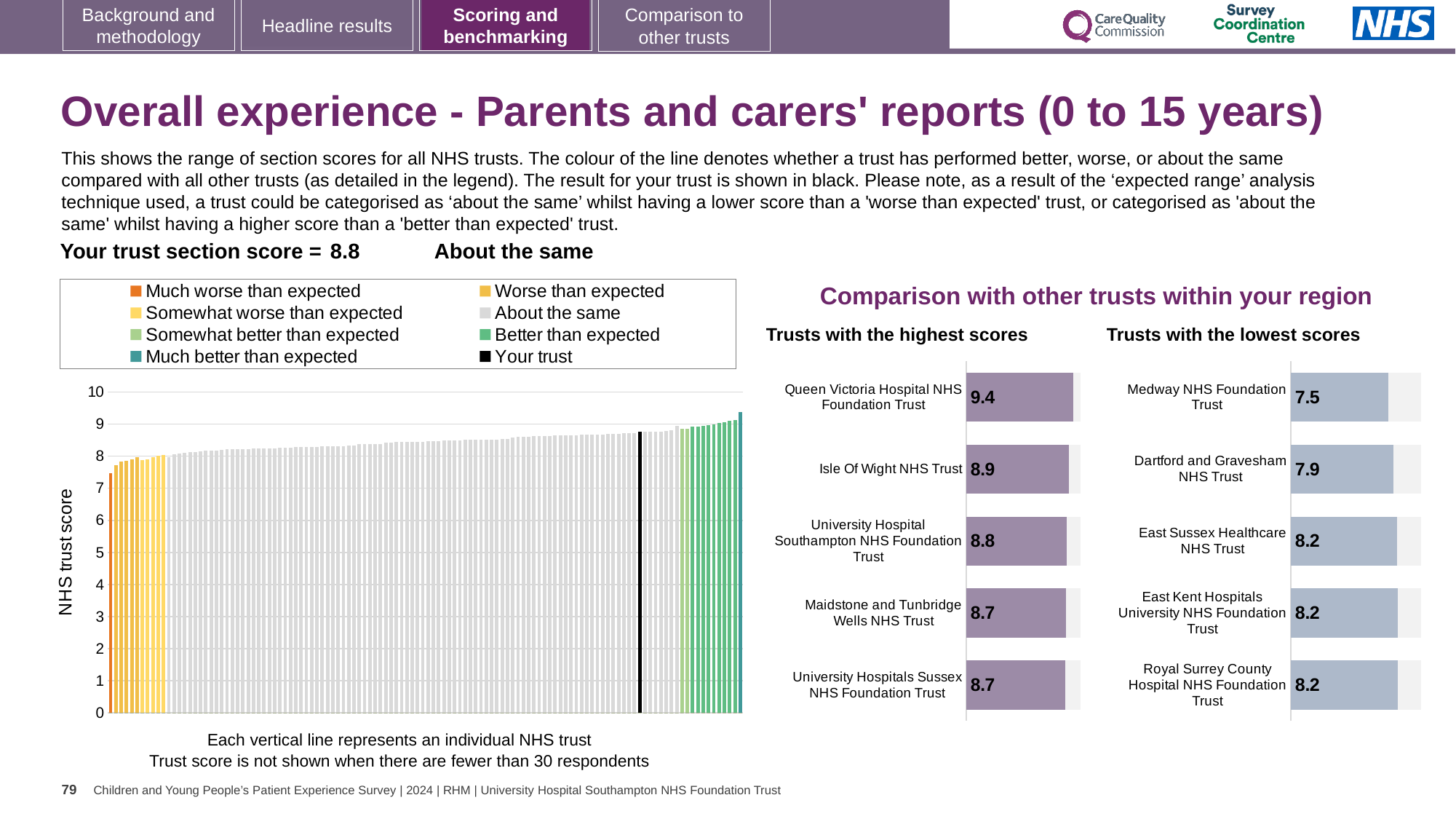
What kind of chart is the large chart on the left showing all NHS trusts? bar chart In the 'Trusts with the lowest scores' chart, which has the larger score: Dartford and Gravesham NHS Trust or Medway NHS Foundation Trust? Dartford and Gravesham NHS Trust In the large chart on the left showing all NHS trusts, is the value of the black bar (your trust) greater or less than 8? greater In the 'Trusts with the lowest scores' chart, which trust has the lowest score? Medway NHS Foundation Trust How many entries does the legend of the large chart on the left list? 8 In the 'Trusts with the highest scores' chart, what is the difference between the scores of Queen Victoria Hospital NHS Foundation Trust and Maidstone and Tunbridge Wells NHS Trust? 0.7 In the 'Trusts with the lowest scores' chart, what is the score for Medway NHS Foundation Trust? 7.5 In the 'Trusts with the highest scores' chart, what is the score for Queen Victoria Hospital NHS Foundation Trust? 9.4 In the 'Trusts with the lowest scores' chart, what is the score for Dartford and Gravesham NHS Trust? 7.9 How many trusts are shown in the 'Trusts with the highest scores' chart? 5 In the 'Trusts with the highest scores' chart, which trust has the highest score? Queen Victoria Hospital NHS Foundation Trust In the 'Trusts with the highest scores' chart, what is the score for Isle Of Wight NHS Trust? 8.9